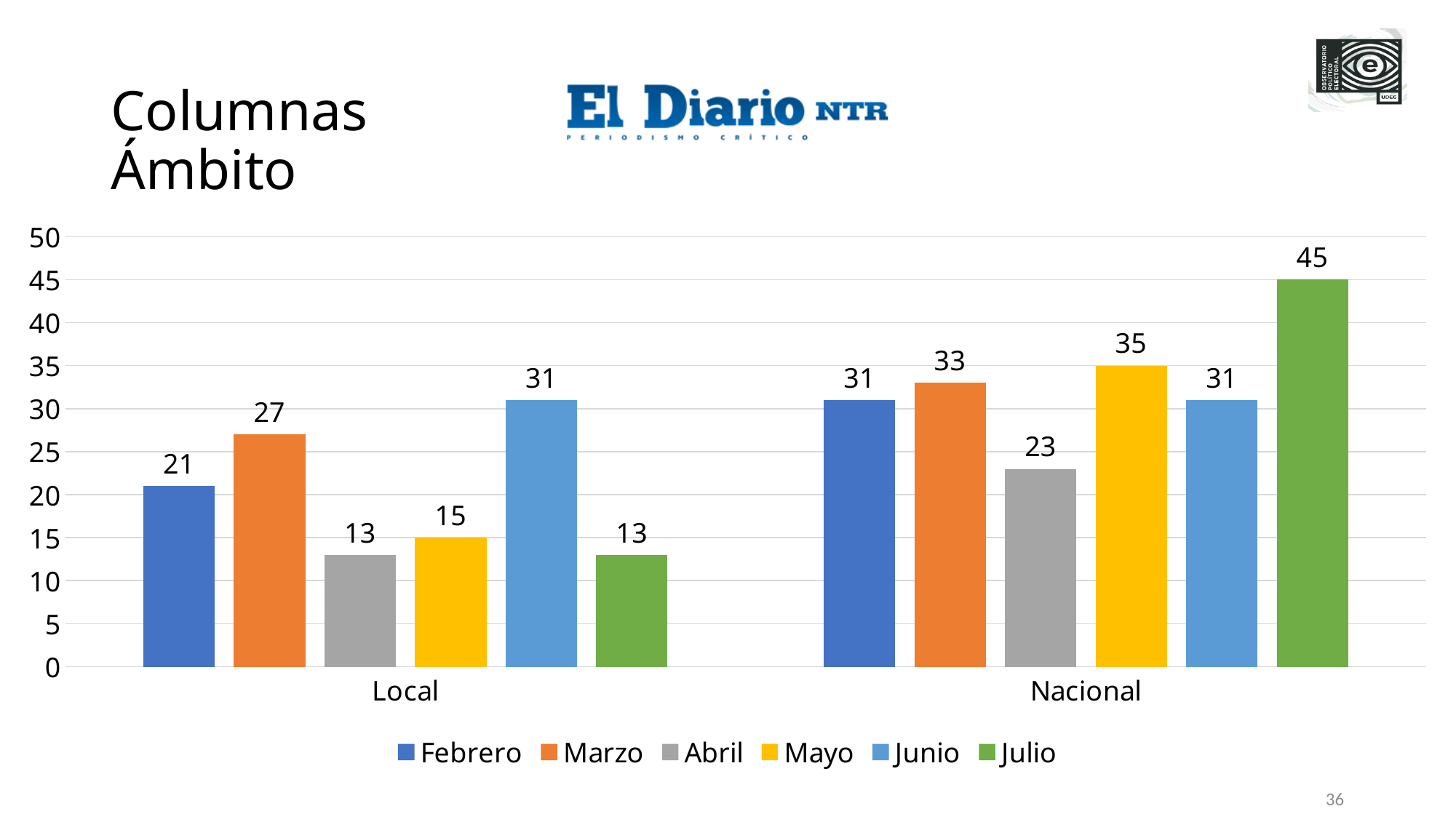
What is the value for Junio in the Local category? 31 How many categories are shown on the x axis? 2 Which month has the highest value in the Nacional category? Julio What is the difference between the Julio values for Nacional and Local? 32 What is the difference between the Marzo and Febrero values in the Local category? 6 What kind of chart is shown on the slide? Bar chart Which month has the lowest value in the Nacional category? Abril Which is larger: the Mayo value for Local or the Mayo value for Nacional? Nacional Which month has the highest value in the Local category? Junio What is the value for Mayo in the Nacional category? 35 How many series does the legend list? 6 What is the value for Abril in the Local category? 13